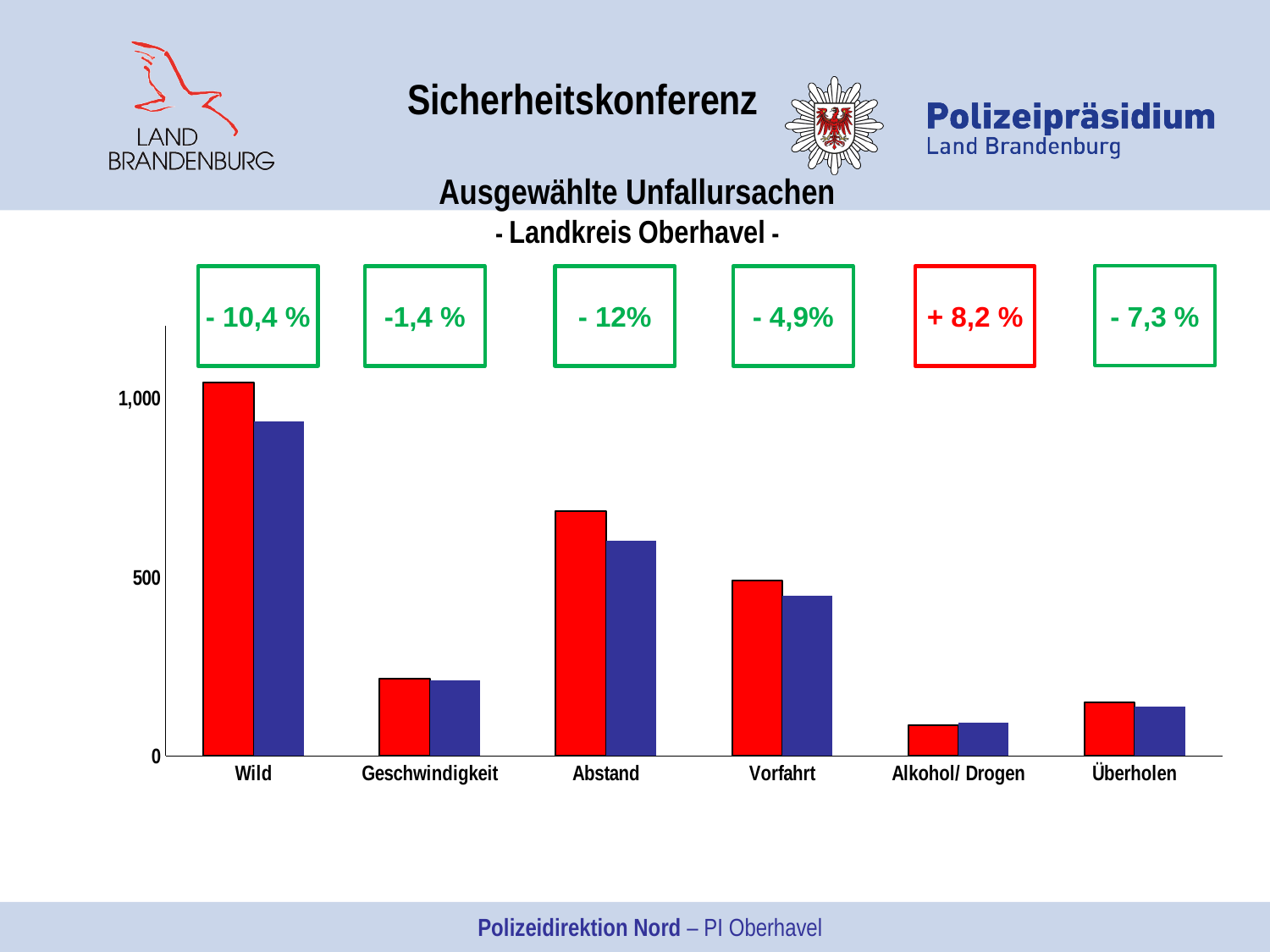
What kind of chart is shown on the slide? bar chart Which category has the highest bars in the chart? Wild Is the value of the blue bar for Wild greater or less than 1,000? less How many categories are shown on the x axis of the chart? 6 Is the value of the blue bar for Vorfahrt greater or less than 500? less What percentage change is shown in the box above the Alkohol/ Drogen category? + 8,2 % Is the value of the red bar for Geschwindigkeit greater or less than 500? less How many bars are shown for each category in the chart? 2 Which has the larger red bar, Überholen or Alkohol/ Drogen? Überholen Which has the larger red bar, Abstand or Vorfahrt? Abstand Which category has the lowest bars in the chart? Alkohol/ Drogen